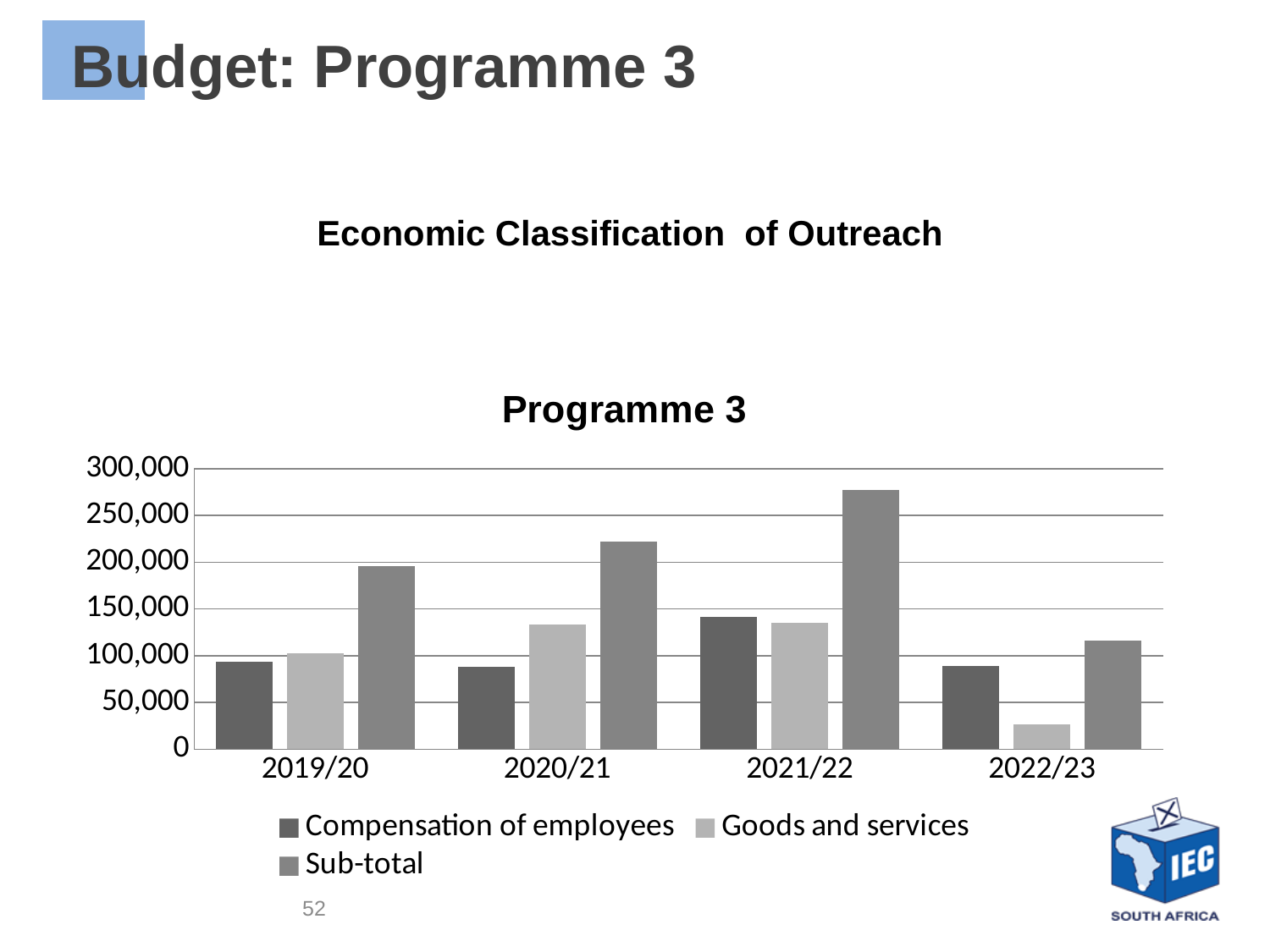
Is the Sub-total value for 2021/22 greater or less than 250,000? greater In 2020/21, which is larger: Compensation of employees or Goods and services? Goods and services In which year is the Sub-total bar the highest? 2021/22 Is the Sub-total value for 2020/21 greater or less than 200,000? greater In which year is the Goods and services bar the lowest? 2022/23 How many financial years are shown on the x axis? 4 Does the Sub-total rise or fall from 2019/20 to 2021/22? Rise How many series does the legend list? 3 Is the Compensation of employees value for 2021/22 greater or less than 100,000? greater What kind of chart is shown on the slide? Bar chart What is the title of the chart? Programme 3